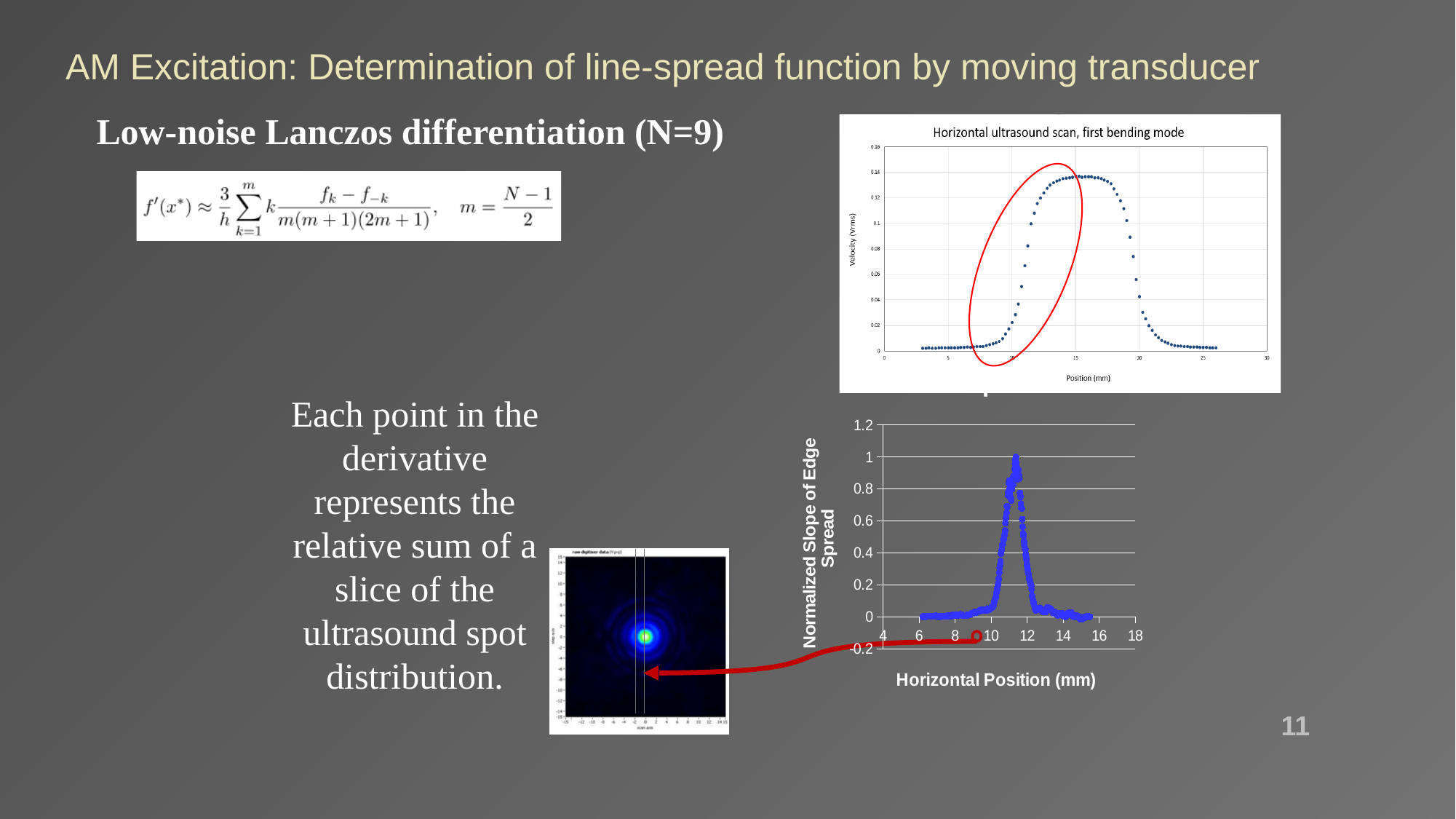
In the 'Horizontal ultrasound scan, first bending mode' chart, is the value at position 15 mm greater or less than 0.1? greater In the bottom-right chart with x axis 'Horizontal Position (mm)', is the value at 8 mm greater or less than 0.2? less In the 'Horizontal ultrasound scan, first bending mode' chart, do the values rise or fall as position increases from 10 mm to 15 mm? rise In the bottom-right chart with x axis 'Horizontal Position (mm)', is the peak value greater or less than 0.8? greater In the bottom-right chart, what is the label of the y axis? Normalized Slope of Edge Spread In the chart titled 'Horizontal ultrasound scan, first bending mode', what is the label of the x axis? Position (mm) What kind of chart is the 'Horizontal ultrasound scan, first bending mode' chart? scatter chart In the 'Horizontal ultrasound scan, first bending mode' chart, do the values rise or fall as position increases from 18 mm to 25 mm? fall What is the title of the chart in the top right of the slide? Horizontal ultrasound scan, first bending mode In the bottom-right chart with x axis 'Horizontal Position (mm)', do the values rise or fall as position increases from 12 mm to 14 mm? fall